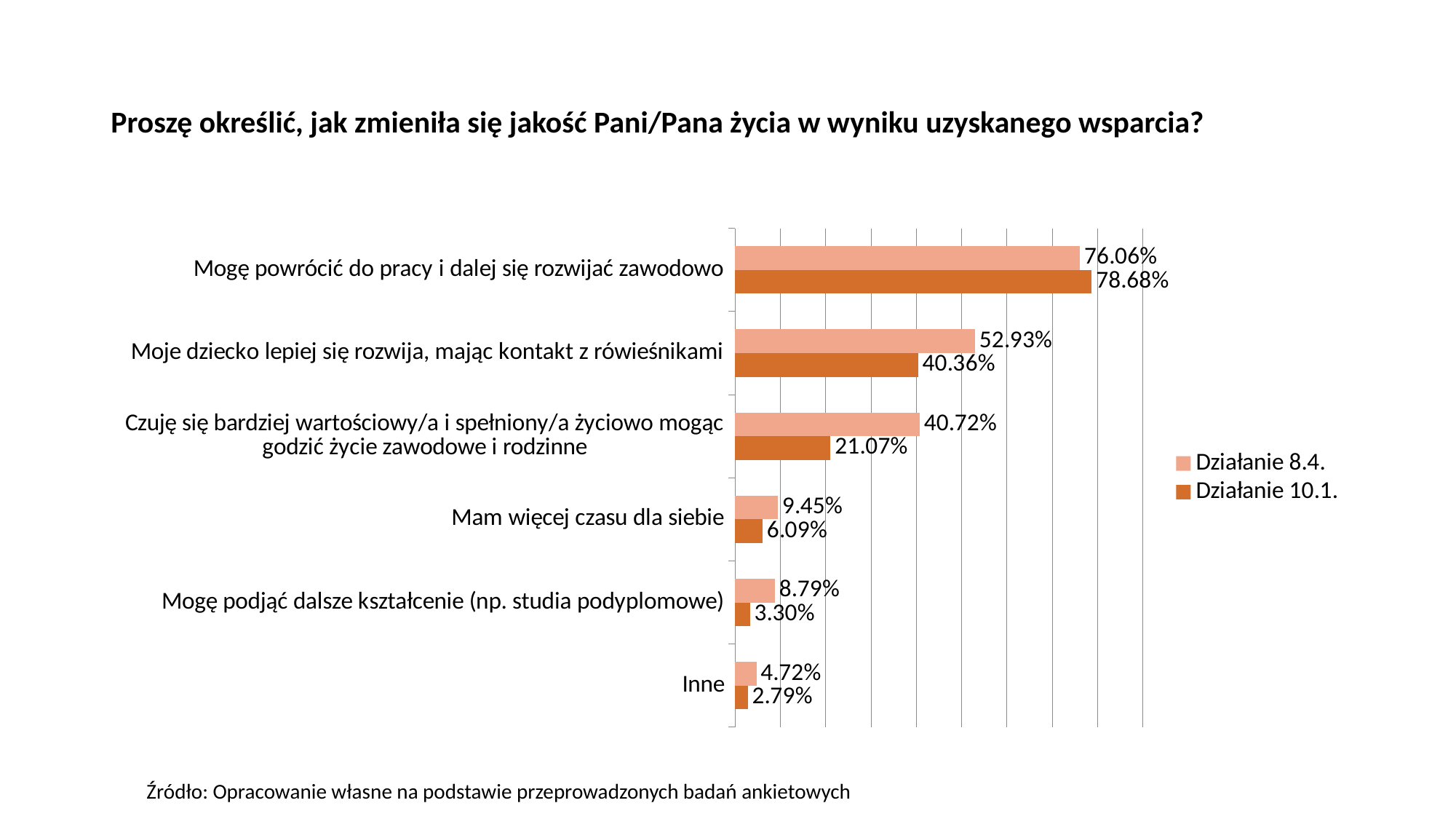
What kind of chart is shown on the slide? Bar chart Which is larger for 'Czuję się bardziej wartościowy/a i spełniony/a życiowo mogąc godzić życie zawodowe i rodzinne': the Działanie 8.4. value or the Działanie 10.1. value? Działanie 8.4. Which category has the highest value for Działanie 8.4.? Mogę powrócić do pracy i dalej się rozwijać zawodowo What is the value for Działanie 10.1. in the category 'Mogę powrócić do pracy i dalej się rozwijać zawodowo'? 78.68% What is the value for Działanie 10.1. in the category 'Mogę podjąć dalsze kształcenie (np. studia podyplomowe)'? 3.30% Which category has the lowest value for Działanie 10.1.? Inne What are the two series names listed in the legend? Działanie 8.4. and Działanie 10.1. Which is larger for 'Mogę powrócić do pracy i dalej się rozwijać zawodowo': the Działanie 8.4. value or the Działanie 10.1. value? Działanie 10.1. How many categories are shown on the chart? 6 What is the difference between the Działanie 8.4. and Działanie 10.1. values for 'Moje dziecko lepiej się rozwija, mając kontakt z rówieśnikami'? 12.57 percentage points What is the value for Działanie 8.4. in the category 'Moje dziecko lepiej się rozwija, mając kontakt z rówieśnikami'? 52.93% How many series does the legend list? 2